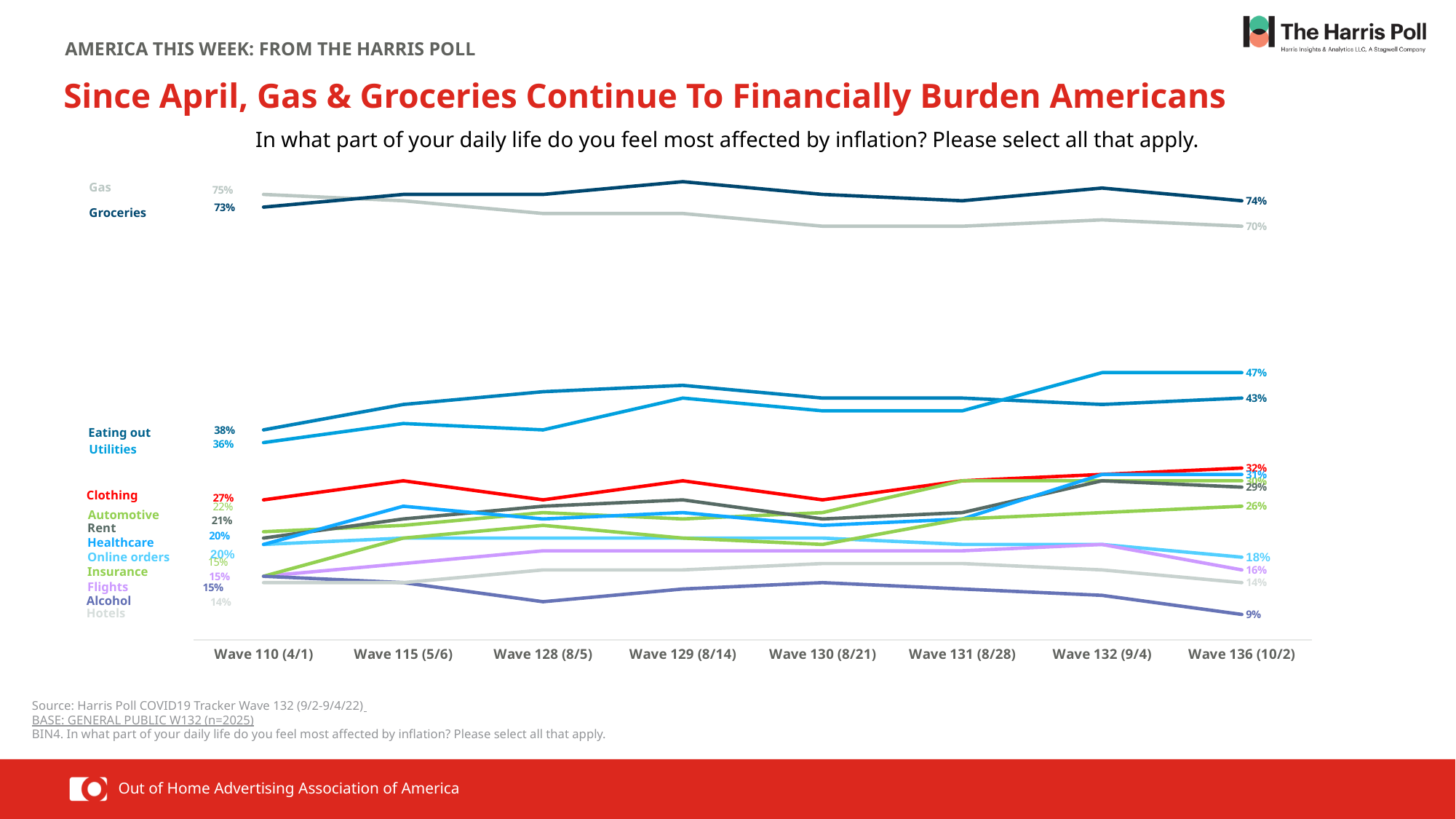
By how many percentage points did Gas fall from Wave 110 (4/1) to Wave 136 (10/2)? 5 percentage points Which category had the lowest value at Wave 136 (10/2)? Alcohol What kind of chart is shown on the slide? Line chart Did the value for Utilities rise or fall from Wave 110 (4/1) to Wave 136 (10/2)? Rise What was the value for Alcohol at Wave 136 (10/2)? 9% What was the value for Groceries at Wave 136 (10/2)? 74% What was the value for Gas at Wave 110 (4/1)? 75% Which category had the highest value at Wave 110 (4/1)? Gas What is the title of the slide above the chart? Since April, Gas & Groceries Continue To Financially Burden Americans How many survey waves are shown along the x axis? 8 What was the value for Utilities at Wave 136 (10/2)? 47% At Wave 136 (10/2), which is higher: Groceries or Gas? Groceries